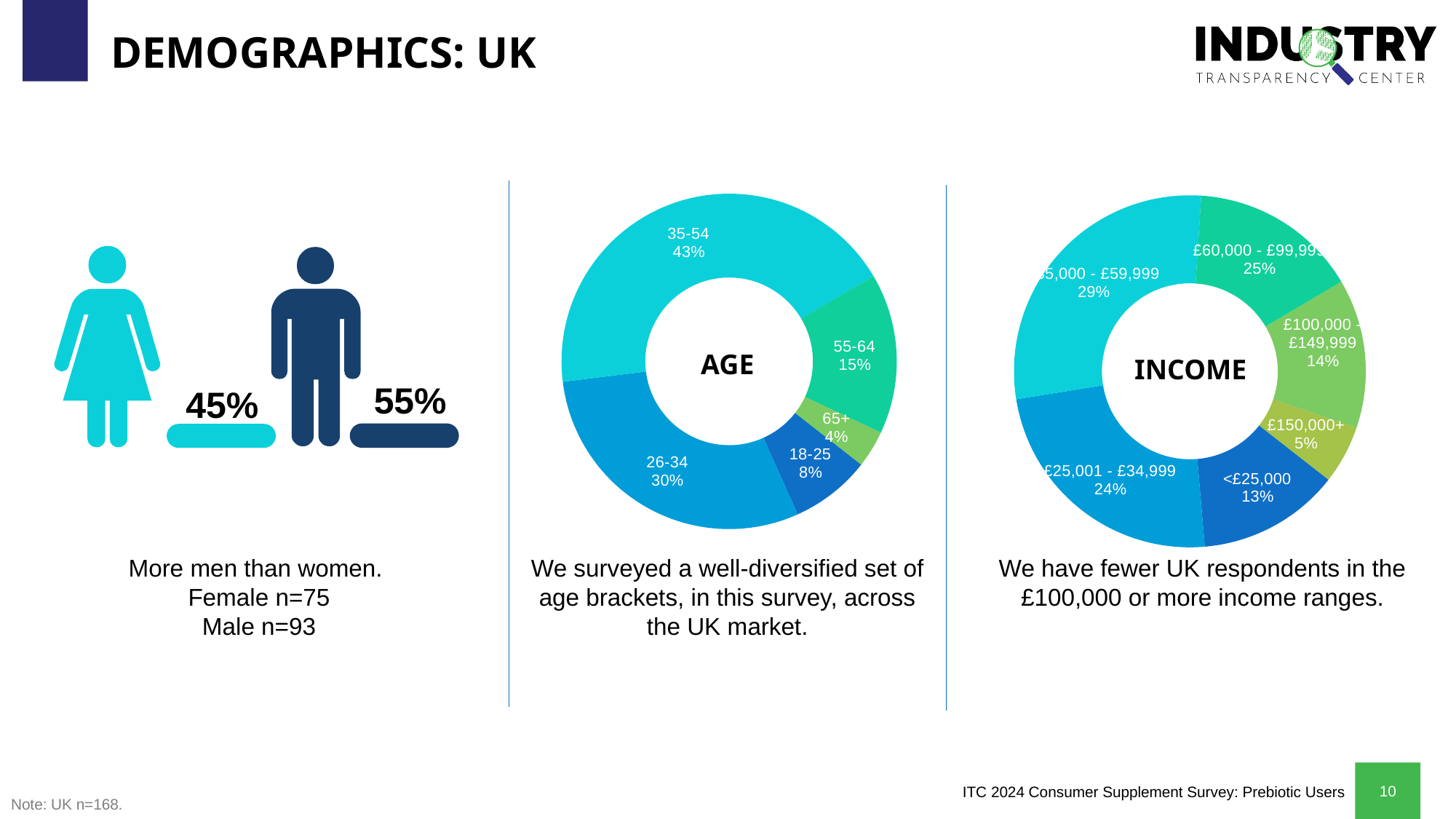
In the INCOME chart, what share of respondents earn £150,000+? 5% In the INCOME chart, what share of respondents earn £60,000 - £99,999? 25% In the AGE chart, how many age brackets are shown? 5 In the AGE chart, what is the difference in percentage points between the 55-64 and 18-25 brackets? 7 In the INCOME chart, which is larger: the share for <£25,000 or the share for £25,001 - £34,999? £25,001 - £34,999 In the INCOME chart, how many income ranges are shown? 6 In the AGE chart, what share of respondents are aged 35-54? 43% In the INCOME chart, which income range has the largest share? £35,000 - £59,999 In the AGE chart, which age bracket has the smallest share? 65+ What kind of chart is the AGE chart? Donut (pie) chart In the AGE chart, which age bracket has the largest share? 35-54 In the AGE chart, what share of respondents are aged 26-34? 30%